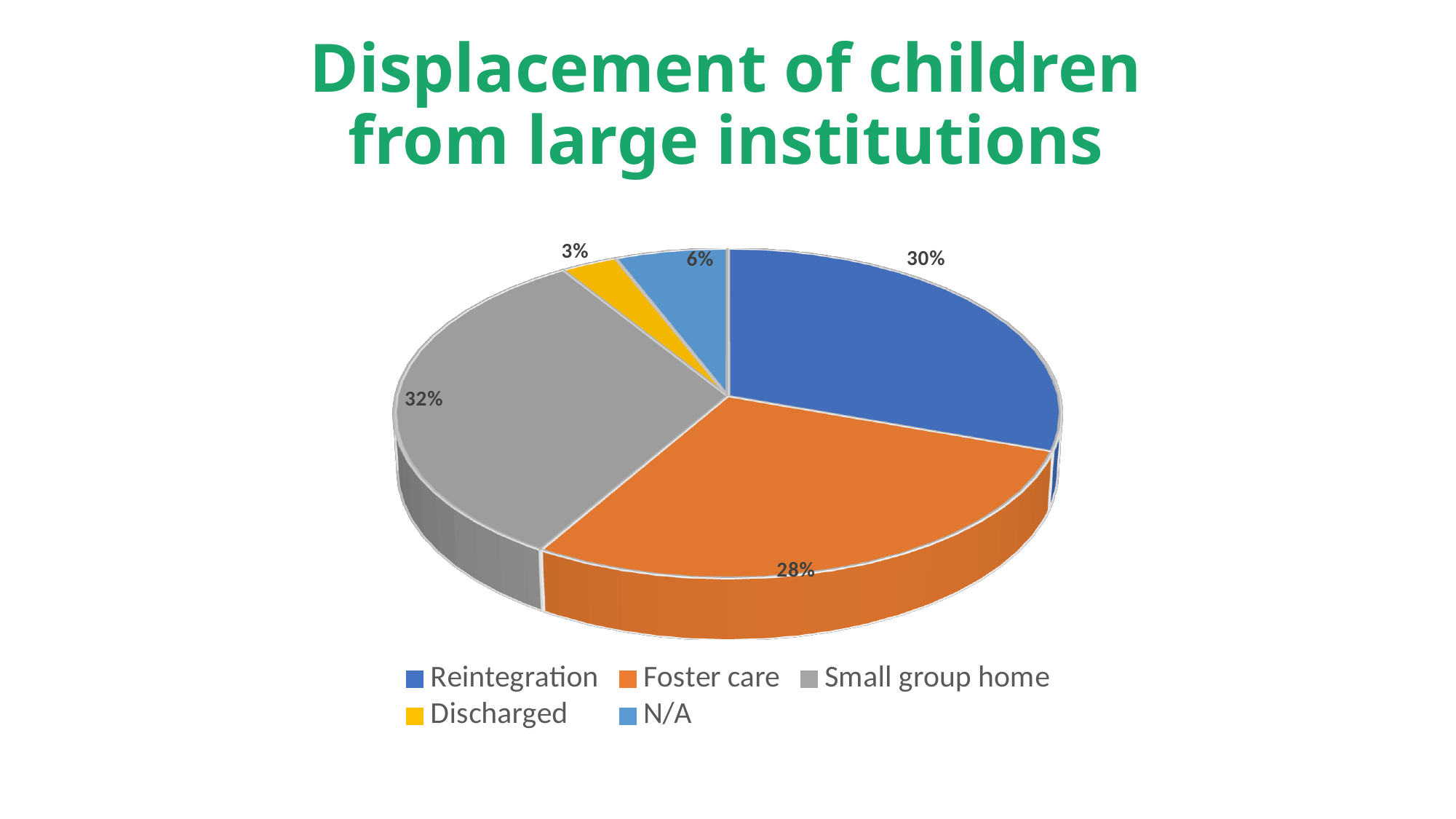
Which category has the smallest share of the pie? Discharged How many categories are shown in the pie chart? 5 Which category has the largest share of the pie? Small group home What share of the pie does Discharged represent? 3% Which is larger, the share for Reintegration or the share for Foster care? Reintegration What is the title of the chart? Displacement of children from large institutions What share of the pie does Reintegration represent? 30% What is the difference in percentage points between Small group home and Foster care? 4 What kind of chart is shown on the slide? Pie chart What share of the pie does Foster care represent? 28% What share of the pie does N/A represent? 6% What share of the pie does Small group home represent? 32%